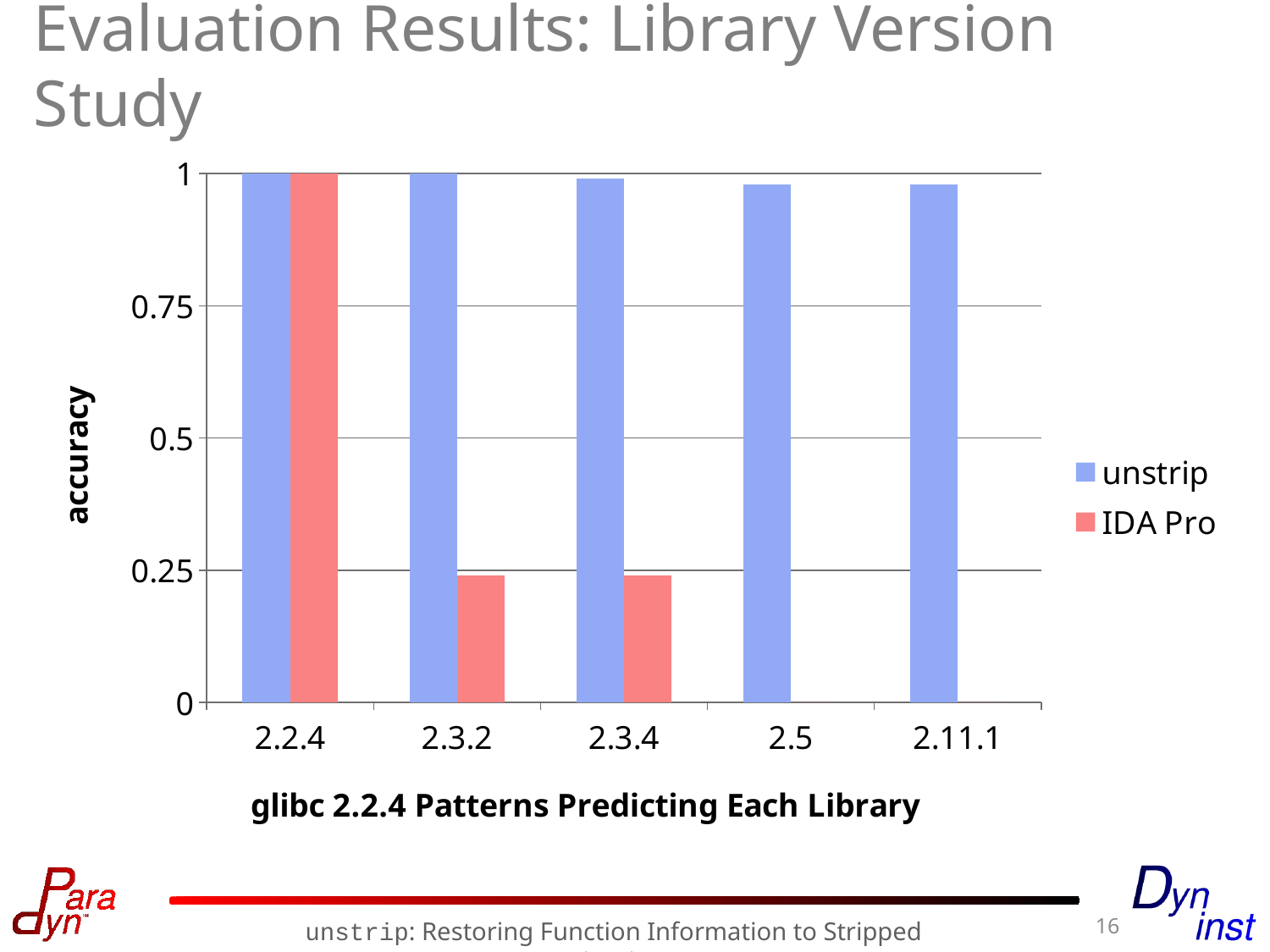
Does the accuracy of IDA Pro rise or fall as the library versions move from 2.2.4 to 2.3.4 along the x axis? fall How many library versions are shown on the x axis of the chart? 5 Is the accuracy of unstrip for version 2.5 greater or less than 0.75? greater For which library version does IDA Pro have its highest accuracy? 2.2.4 What is the label on the y axis of the chart? accuracy What is the accuracy of IDA Pro for library version 2.2.4? 1 Is the accuracy of IDA Pro for version 2.3.2 greater or less than 0.5? less Is the accuracy of unstrip for version 2.11.1 greater or less than 0.5? greater Which series is shown in red in the chart? IDA Pro What kind of chart is shown on the slide? bar chart How many series does the chart legend list? 2 For version 2.3.4, which has the higher accuracy, unstrip or IDA Pro? unstrip